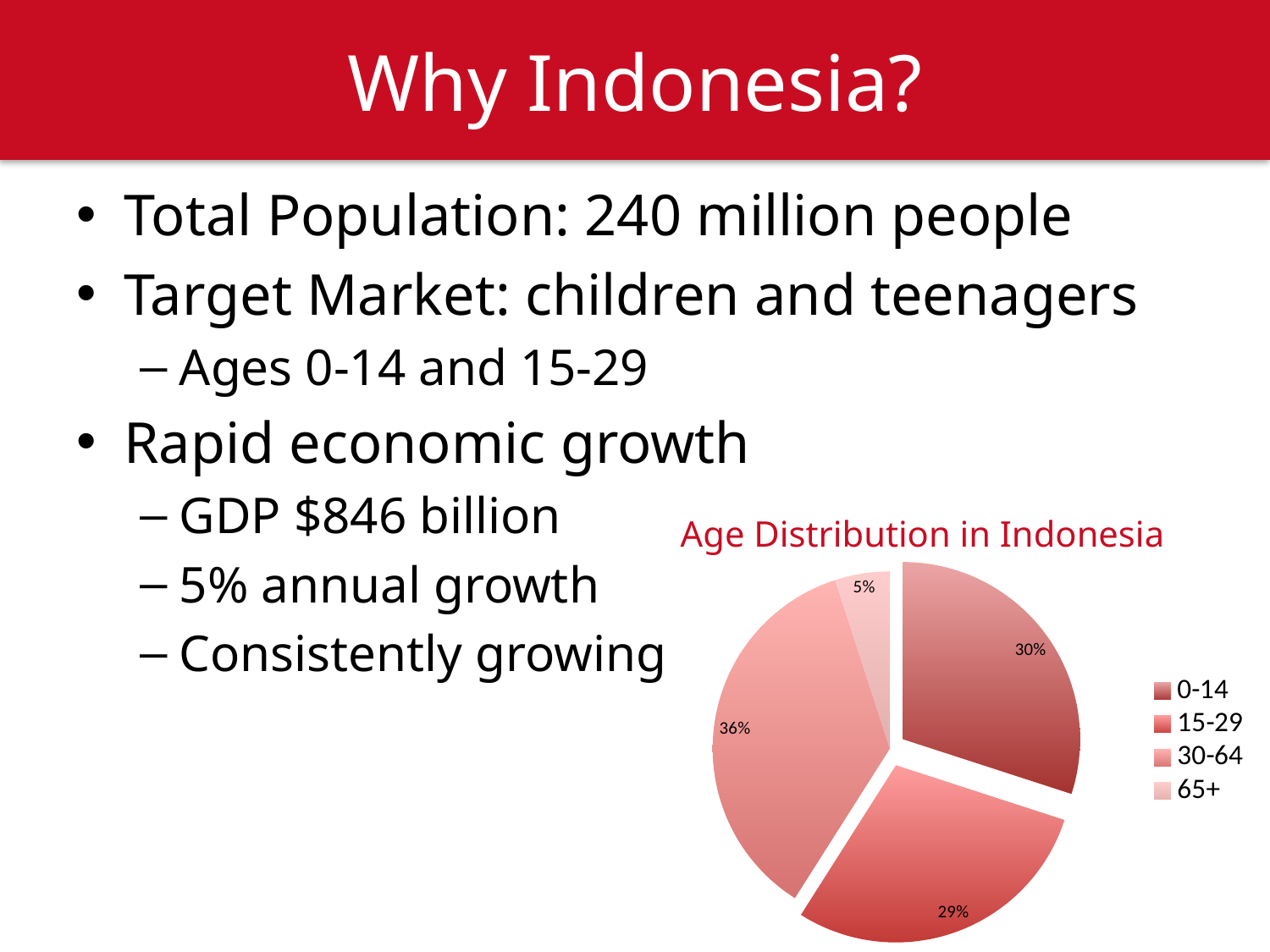
Which age group has the largest share of the pie? 30-64 What type of chart is shown on the slide? pie chart What is the difference between the shares of the 30-64 and 65+ age groups? 31% Which age group has the smallest share of the pie? 65+ What share of the pie does the 0-14 age group have? 30% What is the title of the chart? Age Distribution in Indonesia What is the combined share of the 0-14 and 15-29 age groups? 59% How many age groups are shown in the pie chart? 4 What share of the pie does the 65+ age group have? 5% Which has a larger share, the 0-14 group or the 65+ group? 0-14 What share of the pie does the 15-29 age group have? 29% What share of the pie does the 30-64 age group have? 36%